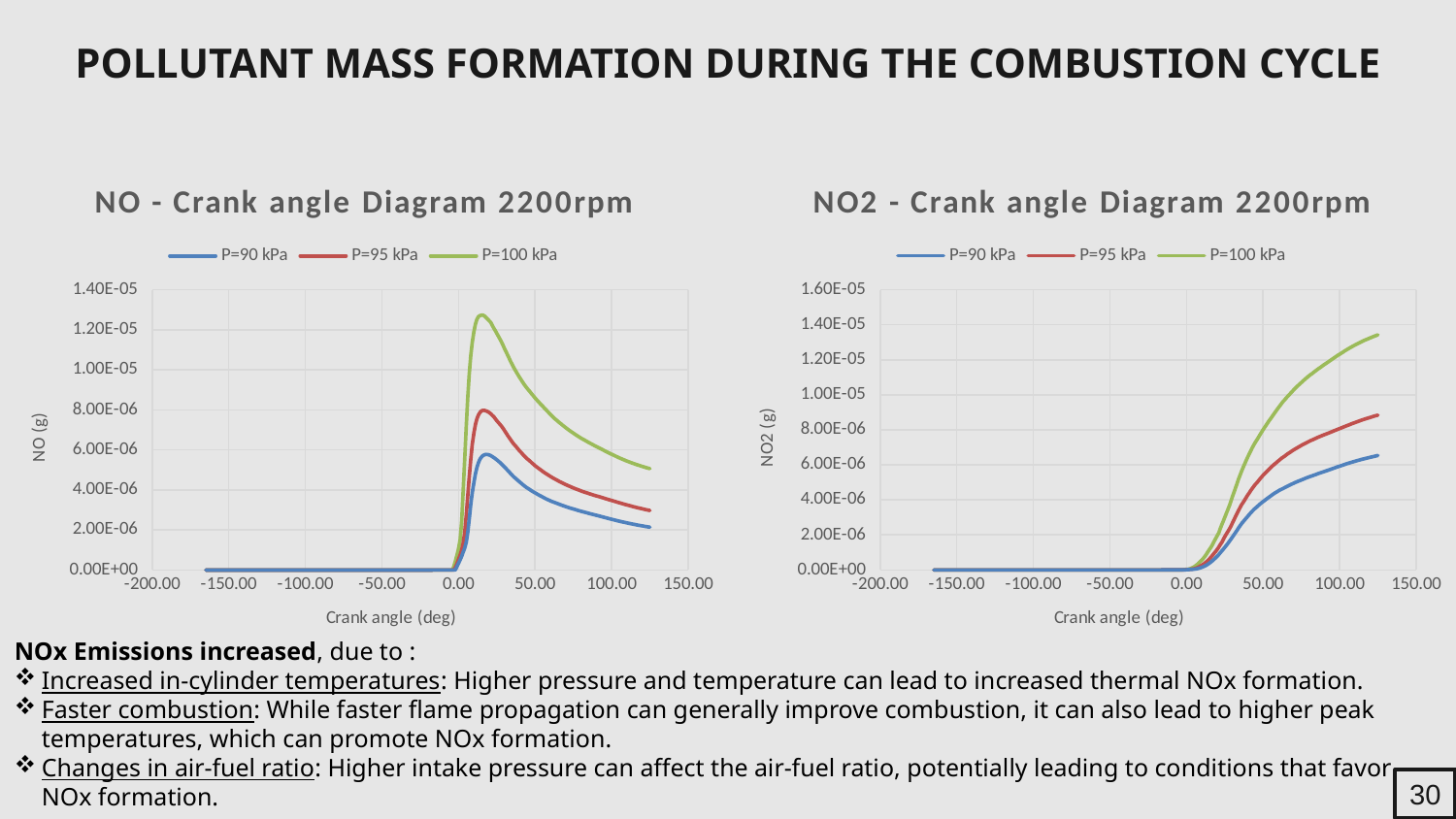
In the NO - Crank angle Diagram 2200rpm, which series reaches the highest peak value? P=100 kPa In the NO2 - Crank angle Diagram 2200rpm, is the value of the P=100 kPa series at its right-hand end greater or less than 1.20E-05? greater What kind of chart is the NO - Crank angle Diagram 2200rpm? Line chart In the NO2 - Crank angle Diagram 2200rpm, is the value of the P=95 kPa series at its right-hand end greater or less than 8.00E-06? greater In the NO2 - Crank angle Diagram 2200rpm, do the values rise or fall between 50.00 and 100.00 deg crank angle? rise How many series does the legend of the NO2 - Crank angle Diagram 2200rpm list? 3 In the NO - Crank angle Diagram 2200rpm, is the peak value of the P=100 kPa series greater or less than 1.20E-05? greater What is the x-axis label of the NO - Crank angle Diagram 2200rpm? Crank angle (deg) In the NO - Crank angle Diagram 2200rpm, do the values rise or fall between 50.00 and 100.00 deg crank angle? fall In the NO2 - Crank angle Diagram 2200rpm, which is larger at 100.00 deg crank angle: the P=100 kPa series or the P=90 kPa series? P=100 kPa In the NO2 - Crank angle Diagram 2200rpm, which series has the lowest value at 100.00 deg crank angle? P=90 kPa